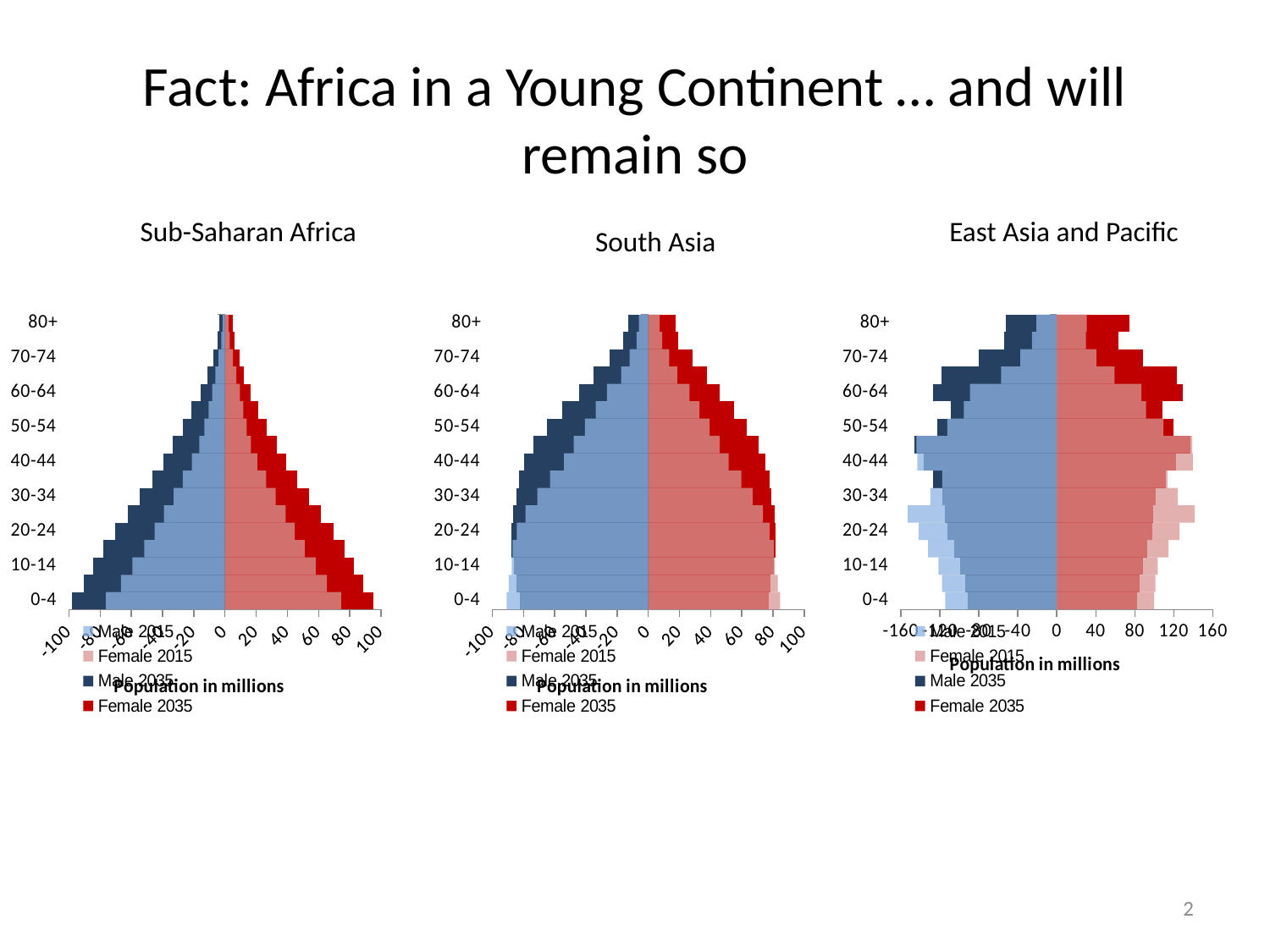
In the Sub-Saharan Africa chart, is the Female 2015 value for the 0-4 age group greater or less than 80? less In the South Asia chart, is the Female 2035 value for the 10-14 age group greater or less than 60? greater What is the x-axis title on the East Asia and Pacific chart? Population in millions What kind of chart is used for the Sub-Saharan Africa population pyramid? bar chart In the Sub-Saharan Africa chart, which age group has the longest Female 2035 bar? 0-4 What is the highest value shown on the x axis of the East Asia and Pacific chart? 160 In the Sub-Saharan Africa chart, do the Female 2035 bars get longer or shorter as the age group increases from 0-4 to 80+? shorter In the East Asia and Pacific chart, which is larger: the Female 2035 bar for 80+ or the Female 2035 bar for 0-4? 0-4 In the South Asia chart, is the Female 2035 value for the 70-74 age group greater or less than 40? less How many series does the legend of the South Asia chart list? 4